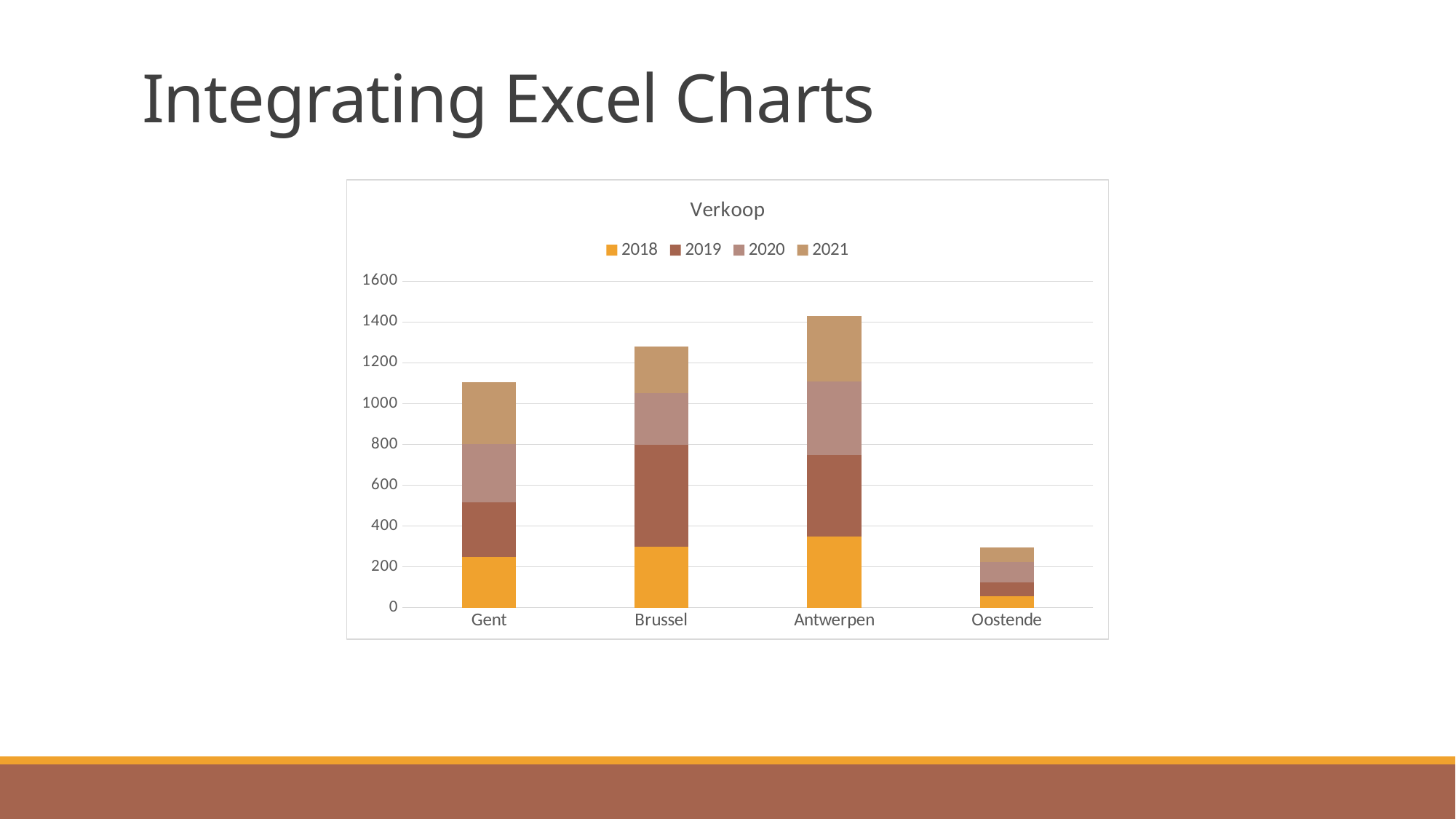
Is the total bar for Antwerpen greater or less than 1200? greater What is the title of the chart? Verkoop Is the 2018 value for Gent greater or less than 400? less Is the total bar for Oostende greater or less than 400? less What kind of chart is shown on the slide? Stacked bar chart Which category has the highest total stacked bar? Antwerpen Which category has the lowest total stacked bar? Oostende How many series does the legend list? 4 How many categories are shown on the x axis? 4 Which series is listed first in the legend? 2018 Which has the larger total bar, Brussel or Gent? Brussel